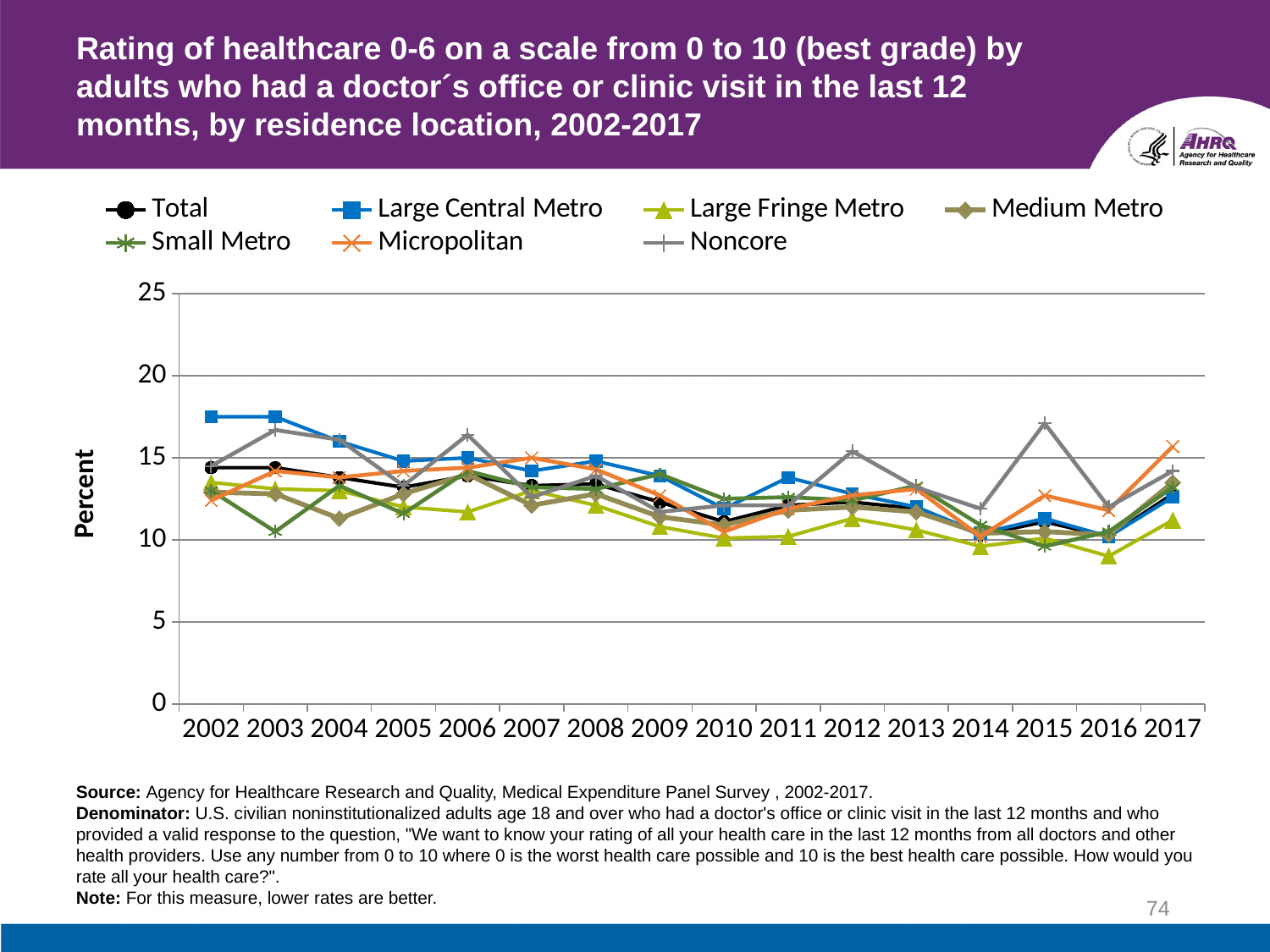
What is the label on the vertical axis? Percent Which series has the lowest value in 2016? Large Fringe Metro How many years are plotted along the x axis? 16 What kind of chart is shown on the slide? Line chart Which series has the highest value in 2002? Large Central Metro In 2015, which is larger: the value for Noncore or the value for Large Fringe Metro? Noncore Which series has the highest value in 2015? Noncore Does the Large Central Metro line generally rise or fall from 2002 to 2016? Fall Is the value for Large Central Metro in 2002 greater or less than 15? greater How many series does the legend list? 7 Is the value for Large Fringe Metro in 2016 greater or less than 10? less Which series has the highest value in 2017? Micropolitan